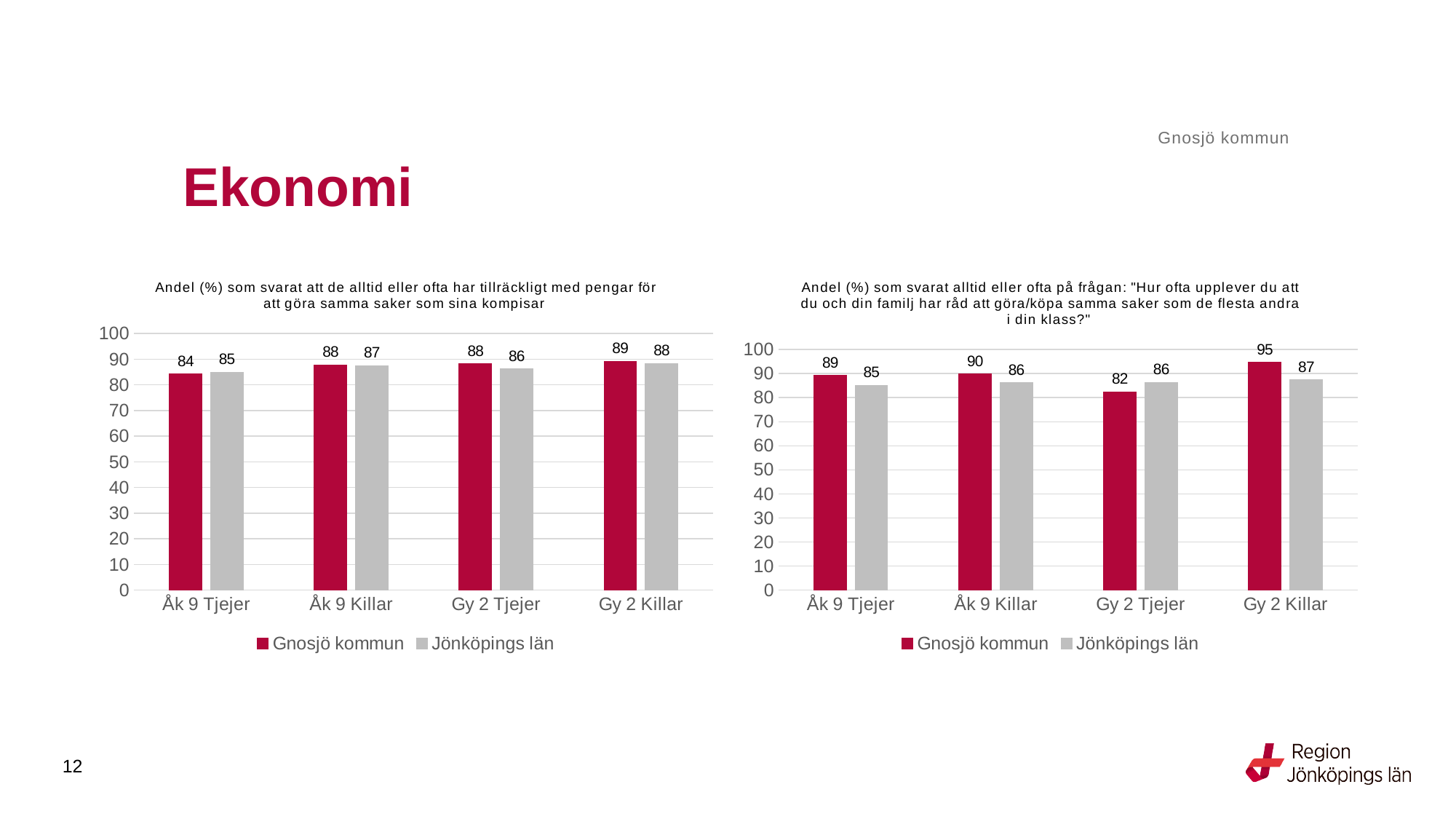
In the right chart, what is the value for Gnosjö kommun for Gy 2 Killar? 95 What kind of chart is the left chart? Bar chart How many categories are shown on the x axis of the left chart? 4 In the left chart, what is the value for Gnosjö kommun for Åk 9 Tjejer? 84 In the right chart, which category has the lowest value for Gnosjö kommun? Gy 2 Tjejer In the right chart, what is the difference between Gnosjö kommun and Jönköpings län for Gy 2 Killar? 8 In the left chart, what is the value for Jönköpings län for Gy 2 Tjejer? 86 In the left chart, what is the difference between Gnosjö kommun for Gy 2 Killar and Gnosjö kommun for Åk 9 Tjejer? 5 In the right chart, what is the value for Jönköpings län for Åk 9 Tjejer? 85 In the right chart, which category has the highest value for Gnosjö kommun? Gy 2 Killar In the right chart, for Gy 2 Tjejer, which is larger: Gnosjö kommun or Jönköpings län? Jönköpings län How many series does the legend of the right chart list? 2